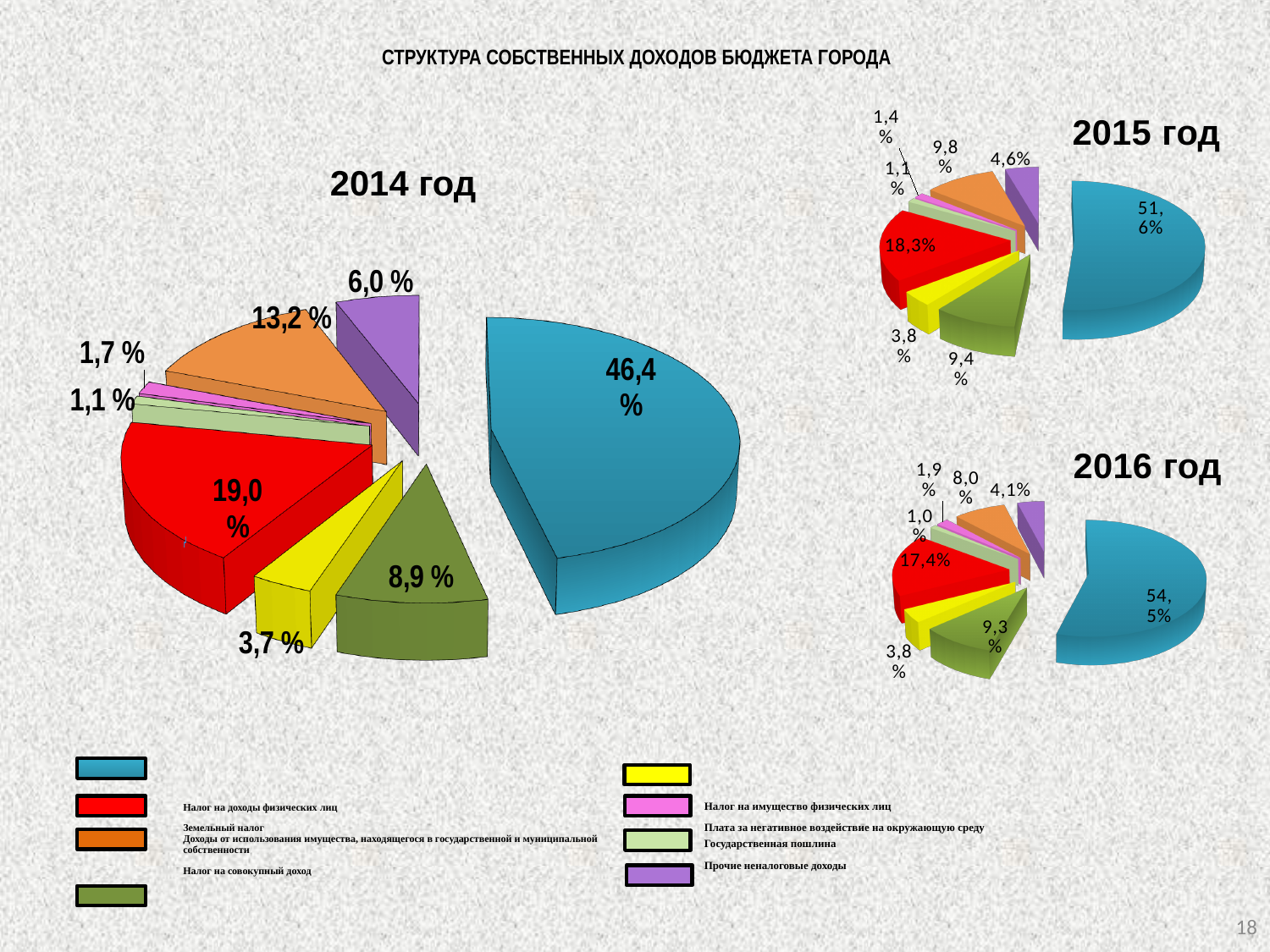
In the 2014 год chart, which slice has the smallest share? the light green slice, 1,1 % What is the title of the slide containing the three pie charts? СТРУКТУРА СОБСТВЕННЫХ ДОХОДОВ БЮДЖЕТА ГОРОДА How many slices does the 2016 год pie chart have? 8 In the 2016 год chart, what is the value of the red slice? 17,4% In the 2016 год chart, what is the value of the orange slice? 8,0% In the 2014 год chart, what is the value of the largest (blue) slice? 46,4 % What kind of chart is used for the 2014 год chart? pie chart In the 2015 год chart, what is the difference between the blue slice and the red slice? 33,3% In the 2014 год chart, which is larger: the orange slice or the green slice? the orange slice (13,2 %) Does the share of the blue slice rise or fall from 2014 to 2016? rise In the 2014 год chart, what is the value of the red slice? 19,0 % In the 2015 год chart, what is the value of the blue slice? 51,6%